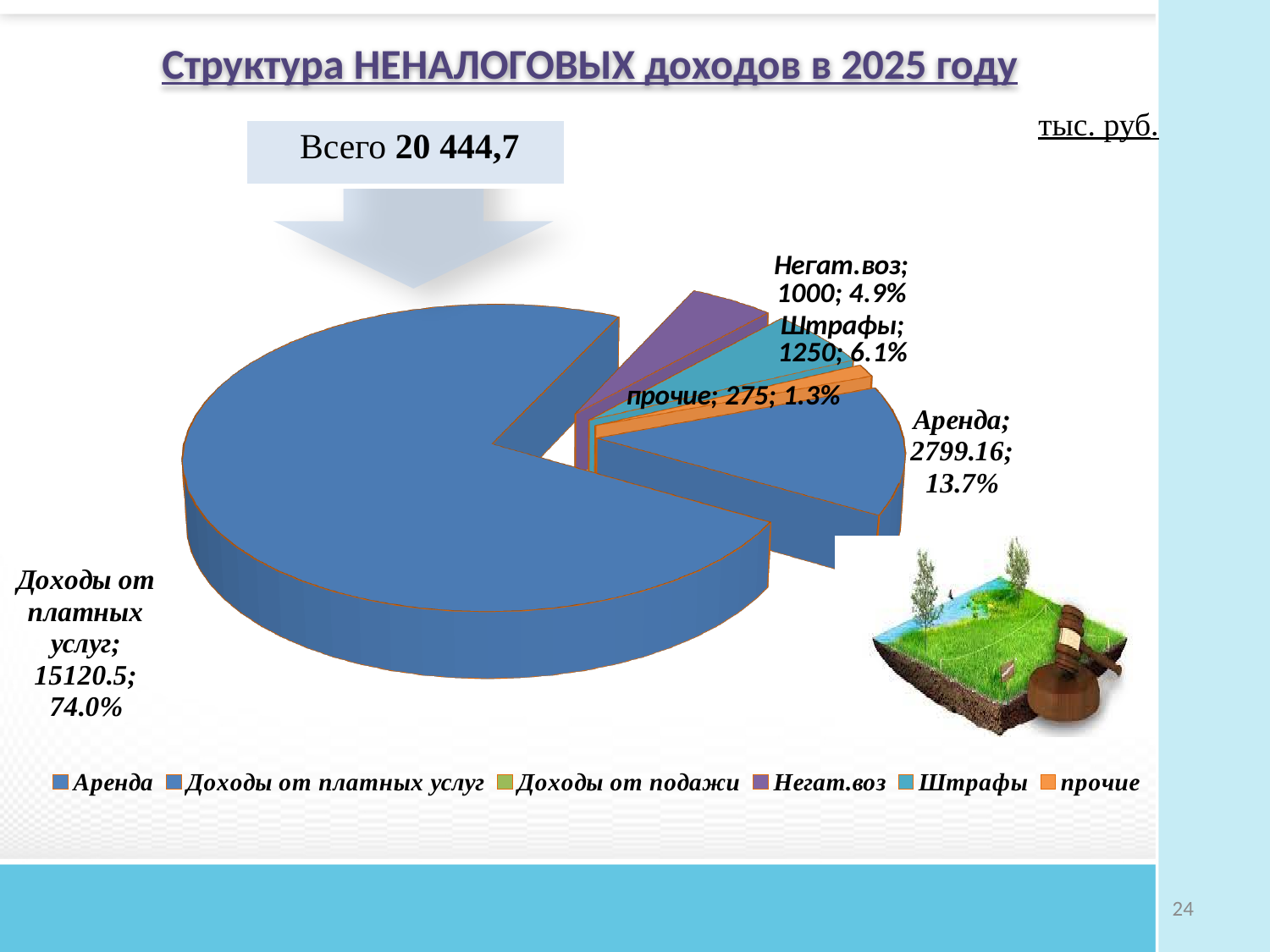
What total (Всего) is shown above the chart? 20 444,7 Which labelled category has the smallest slice of the pie? прочие Which category has the largest slice of the pie? Доходы от платных услуг What kind of chart is shown on the slide? pie chart What value is shown for Штрафы? 1250 What value is shown for прочие? 275 What value is shown for Доходы от платных услуг? 15120.5 How many entries does the legend list? 6 What is the difference between the values for Штрафы and Негат.воз? 250 What share of the pie does Аренда represent? 13.7% What share of the pie does Негат.воз represent? 4.9% Which is larger, Штрафы or Негат.воз? Штрафы